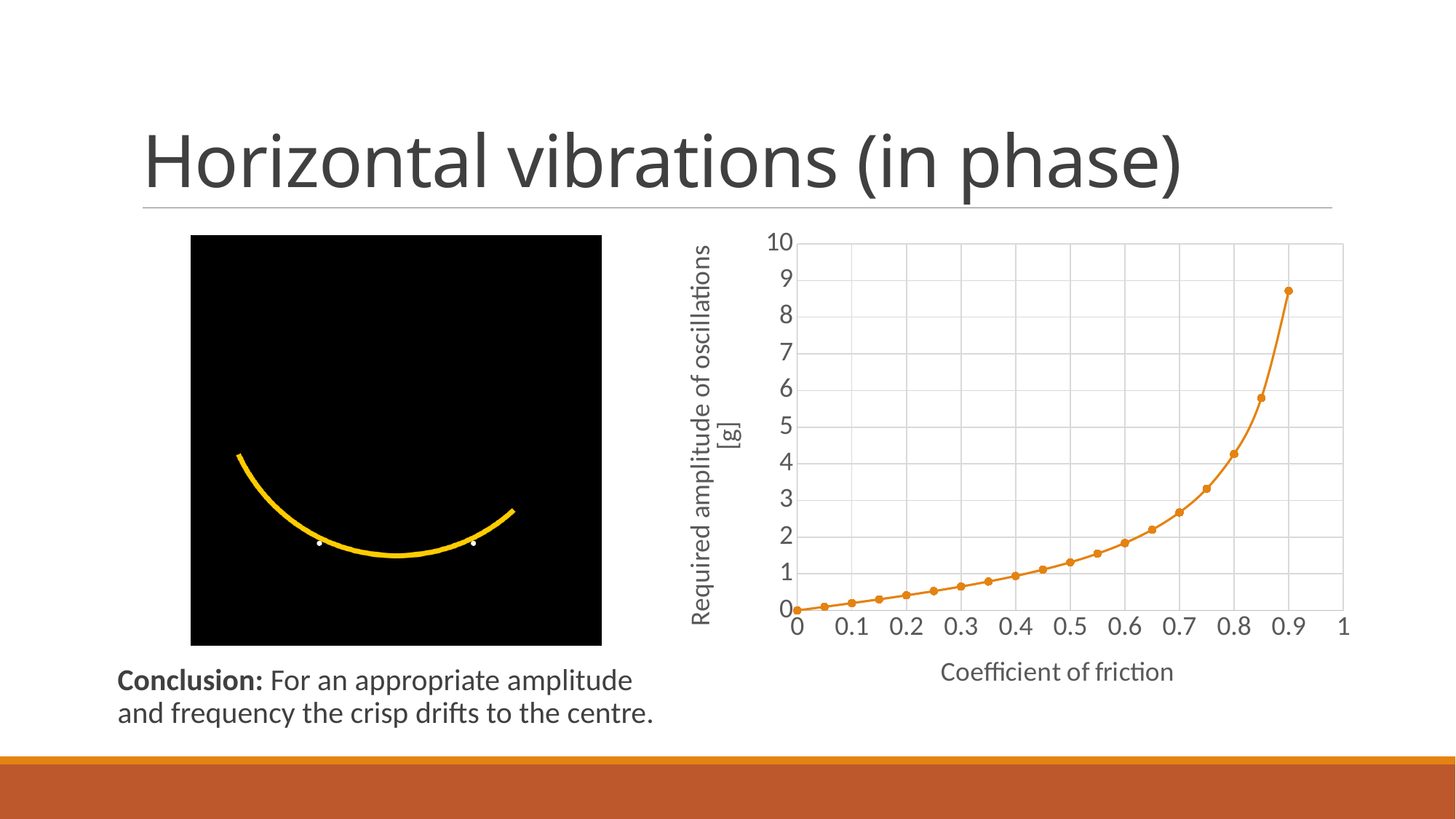
At which coefficient of friction is the required amplitude of oscillations highest? 0.9 What is the title of the x axis of the chart? Coefficient of friction Is the required amplitude at a coefficient of friction of 0.85 greater or less than 5? greater How many data points are plotted on the chart? 19 Is the required amplitude at a coefficient of friction of 0.7 greater or less than 3? less What is the required amplitude of oscillations at a coefficient of friction of 0? 0 Does the required amplitude of oscillations rise or fall as the coefficient of friction increases? rise Is the required amplitude at a coefficient of friction of 0.3 greater or less than 1? less At which coefficient of friction is the required amplitude of oscillations lowest? 0 Which has a larger required amplitude: a coefficient of friction of 0.8 or 0.6? 0.8 What kind of chart is shown on the slide? line chart